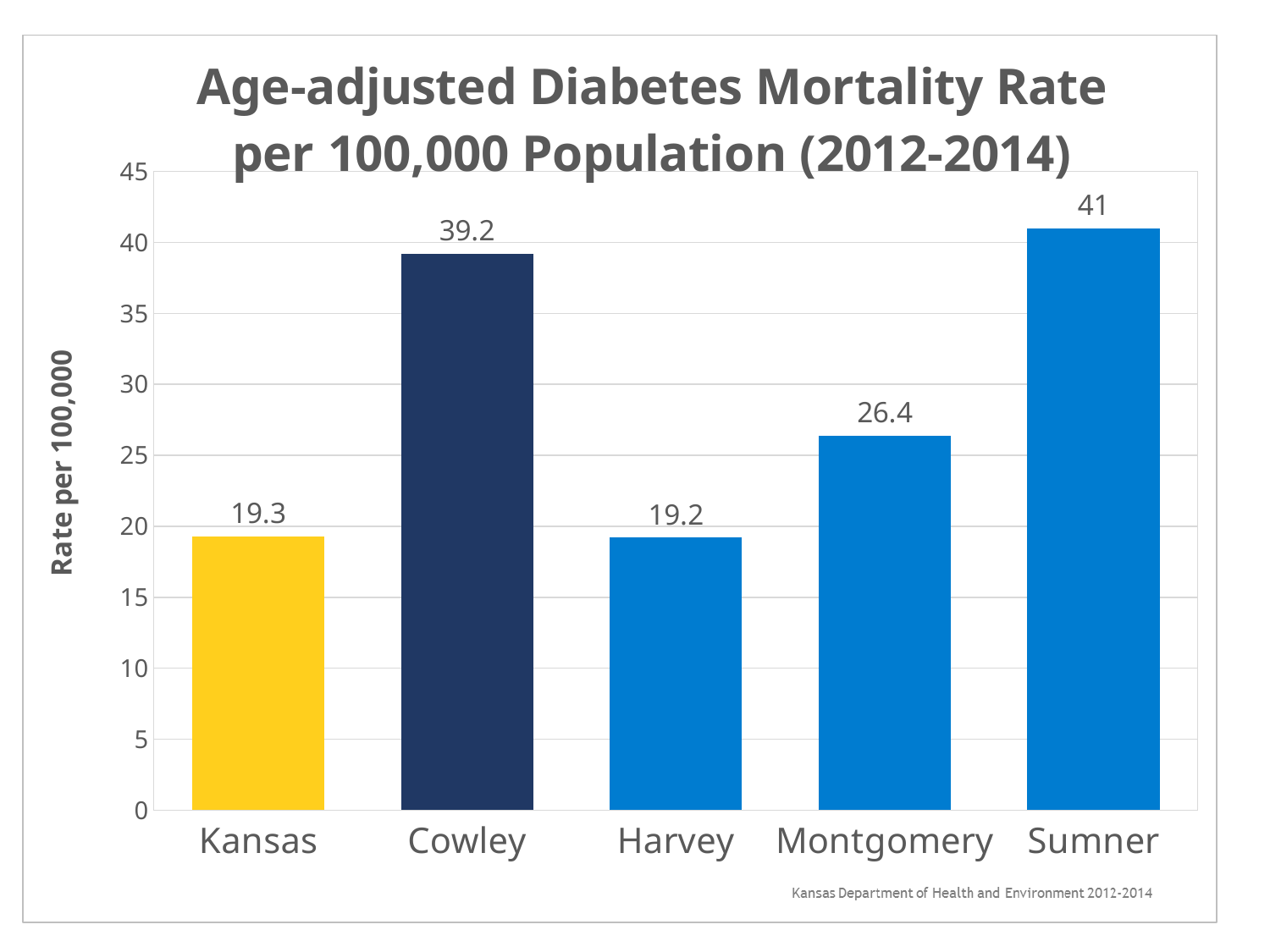
Which has a higher rate, Cowley or Montgomery? Cowley What is the age-adjusted diabetes mortality rate for Montgomery? 26.4 What is the age-adjusted diabetes mortality rate for Cowley? 39.2 What is the age-adjusted diabetes mortality rate for Sumner? 41 What is the difference between the rates for Montgomery and Harvey? 7.2 How many categories are shown on the x axis? 5 Which category has the lowest age-adjusted diabetes mortality rate? Harvey Is the value for Montgomery greater or less than 25? greater What is the difference between the rates for Sumner and Cowley? 1.8 What kind of chart is shown on the slide? bar chart Which category has the highest age-adjusted diabetes mortality rate? Sumner What is the age-adjusted diabetes mortality rate for Kansas? 19.3